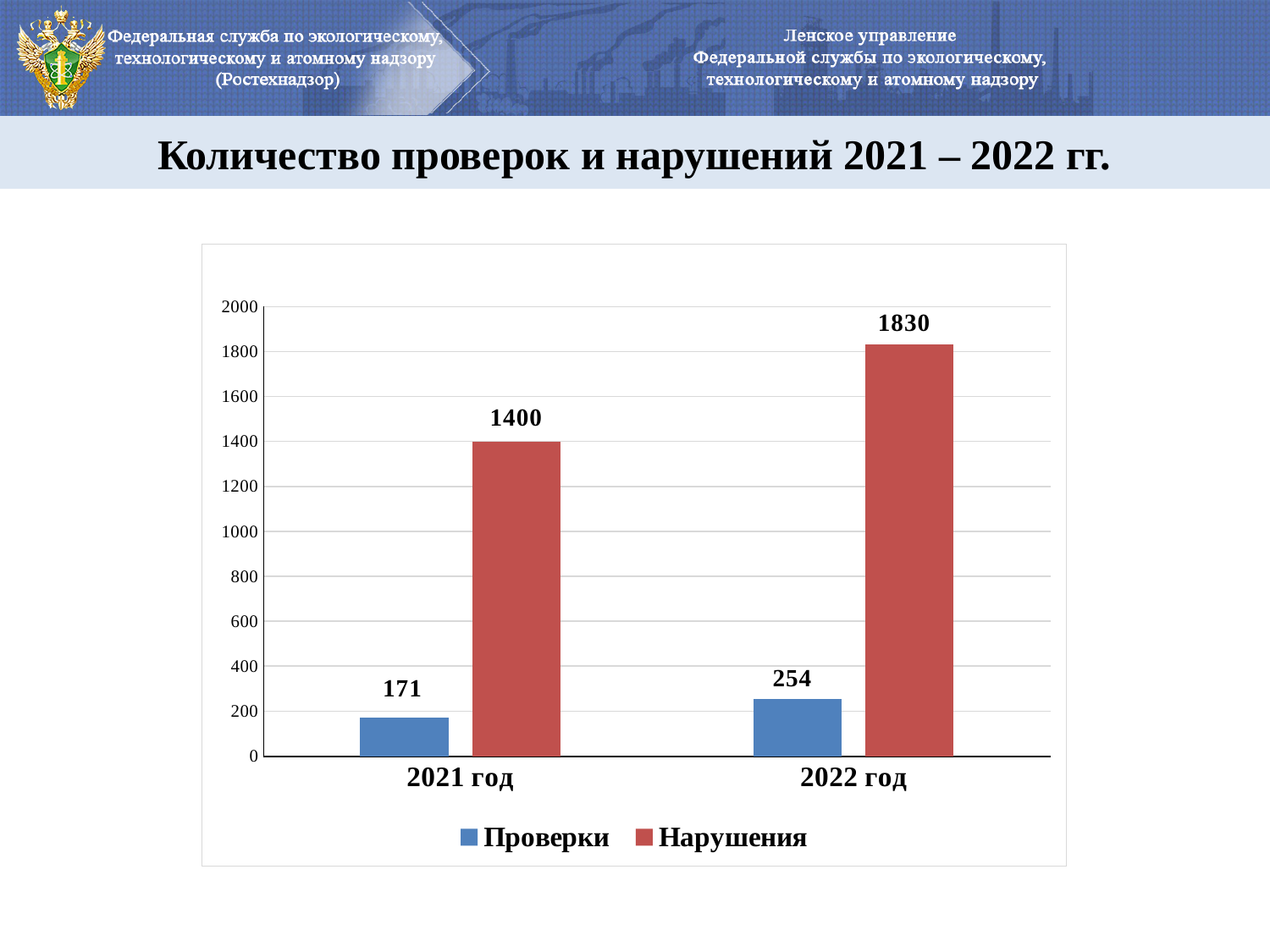
What is the value of Нарушения for 2022 год? 1830 What is the value of Проверки for 2021 год? 171 Which year has the higher value for Нарушения? 2022 год What is the value of Нарушения for 2021 год? 1400 What is the difference between Проверки in 2022 год and 2021 год? 83 What kind of chart is shown on the slide? Bar chart What is the value of Проверки for 2022 год? 254 What is the difference between Нарушения in 2022 год and 2021 год? 430 Which is larger: Проверки in 2022 год or Нарушения in 2021 год? Нарушения in 2021 год How many series does the legend list? 2 Do the values for Проверки rise or fall from 2021 год to 2022 год? Rise Which year has the lower value for Проверки? 2021 год